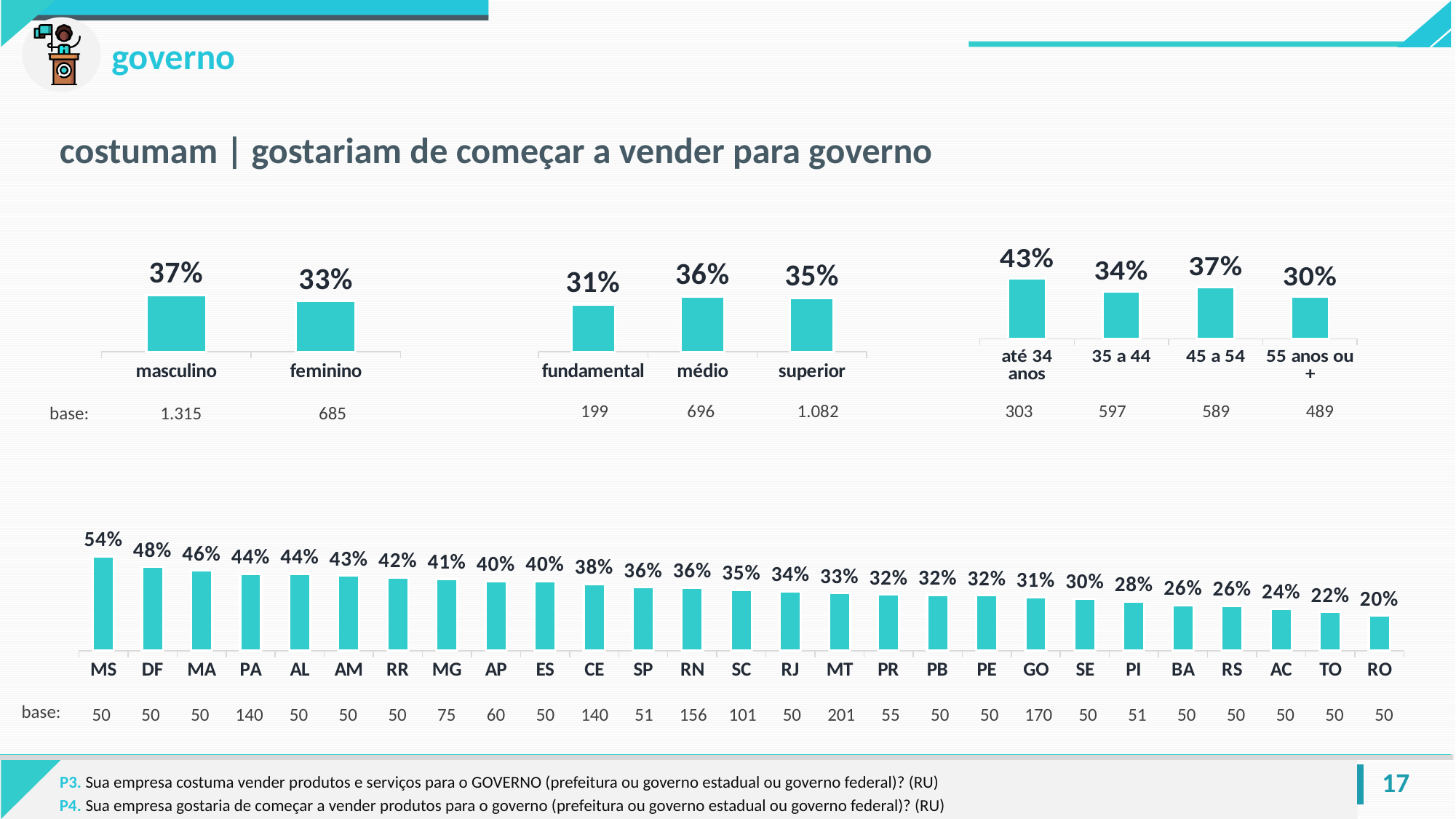
In the state chart (bottom), what is the difference between MS and RO? 34 percentage points What kind of chart is the state chart at the bottom of the slide? bar chart In the age chart (top right), what is the value for até 34 anos? 43% In the state chart (bottom), do the values rise or fall from left to right? fall In the education chart (top centre), which category has the highest value? médio In the state chart (bottom), what is the value for GO? 31% In the education chart (top centre), what is the value for fundamental? 31% In the gender chart (top left), what is the value for masculino? 37% In the state chart (bottom), which state has the highest value? MS In the gender chart (top left), what is the difference between masculino and feminino? 4 percentage points In the age chart (top right), which age group has the lowest value? 55 anos ou + In the age chart (top right), how many age groups are shown? 4